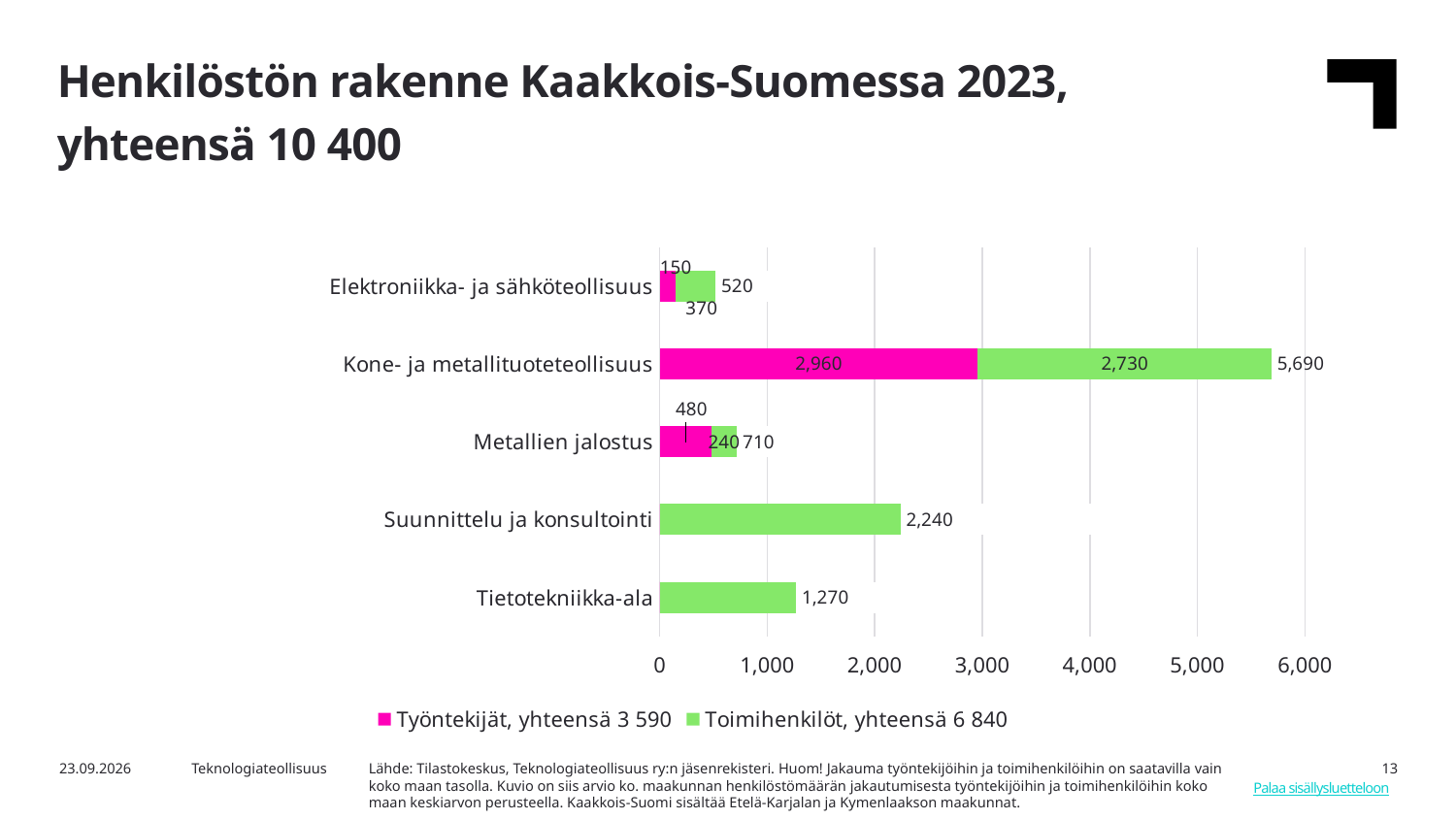
What is the Työntekijät value for Kone- ja metallituoteteollisuus? 2,960 Which is larger for Kone- ja metallituoteteollisuus: the Työntekijät value or the Toimihenkilöt value? Työntekijät How many categories are shown on the chart? 5 Which category has the lowest total personnel? Elektroniikka- ja sähköteollisuus What kind of chart is shown on the slide? Stacked bar chart What is the total shown for the Kone- ja metallituoteteollisuus bar? 5,690 What is the Toimihenkilöt value for Elektroniikka- ja sähköteollisuus? 370 How many series does the legend list? 2 What is the Työntekijät value for Metallien jalostus? 480 What is the difference between the Toimihenkilöt values for Suunnittelu ja konsultointi and Tietotekniikka-ala? 970 What is the Toimihenkilöt value for Suunnittelu ja konsultointi? 2,240 Which category has the highest total personnel? Kone- ja metallituoteteollisuus